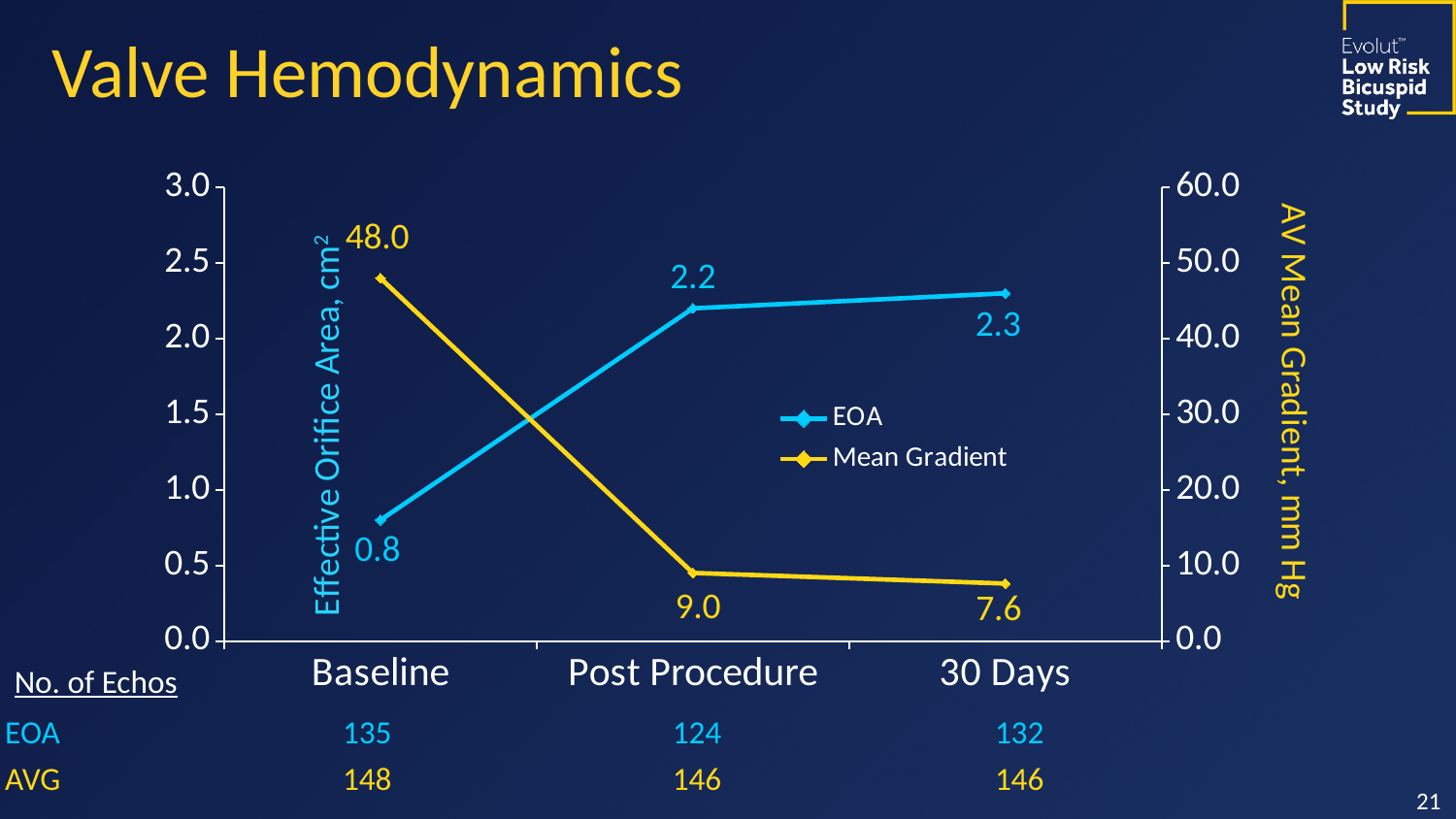
What is the difference between the Mean Gradient at Baseline and at Post Procedure? 39.0 At which time point is the EOA lowest? Baseline What is the Mean Gradient value at Post Procedure? 9.0 What kind of chart is shown on the slide? Line chart What is the EOA value at 30 Days? 2.3 How many series does the legend list? 2 At which time point is the Mean Gradient highest? Baseline What is the difference between the EOA at Post Procedure and at Baseline? 1.4 How many time points are shown on the x axis? 3 Which is larger, the Mean Gradient at Baseline or at 30 Days? Baseline What is the Mean Gradient value at 30 Days? 7.6 What is the EOA value at Baseline? 0.8